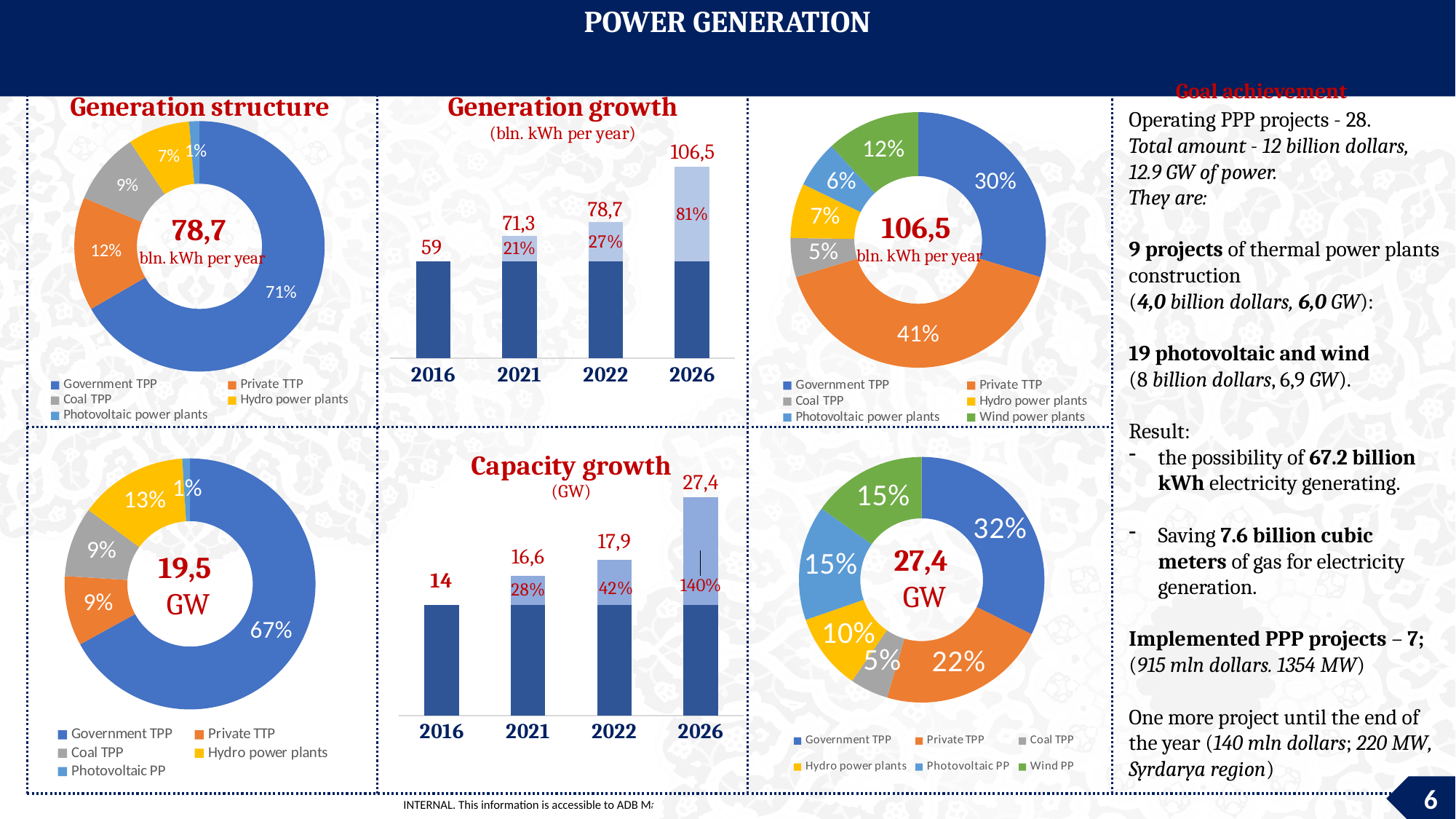
In the 'Generation growth' bar chart, how many years are shown on the x axis? 4 In the bottom-right donut chart (27,4 GW), which is larger: the share for Government TPP or the share for Private TPP? Government TPP In the 'Capacity growth' bar chart, what is the value for 2022? 17,9 In the 'Capacity growth' bar chart, what is the difference between the 2026 value and the 2016 value? 13,4 In the bottom-left donut chart (19,5 GW), what share is shown for Hydro power plants? 13% In the top-right donut chart (106,5 bln. kWh per year), what share is shown for Private TTP? 41% In the 'Generation structure' donut chart at the top left, what share is shown for Government TPP? 71% In the 'Generation growth' bar chart, what is the value for 2016? 59 In the 'Generation growth' bar chart, what is the value for 2026? 106,5 In the 'Generation structure' donut chart at the top left, which category has the smallest share? Photovoltaic power plants In the 'Generation growth' bar chart, do the values rise or fall from 2016 to 2026? rise In the top-right donut chart (106,5 bln. kWh per year), how many categories does the legend list? 6